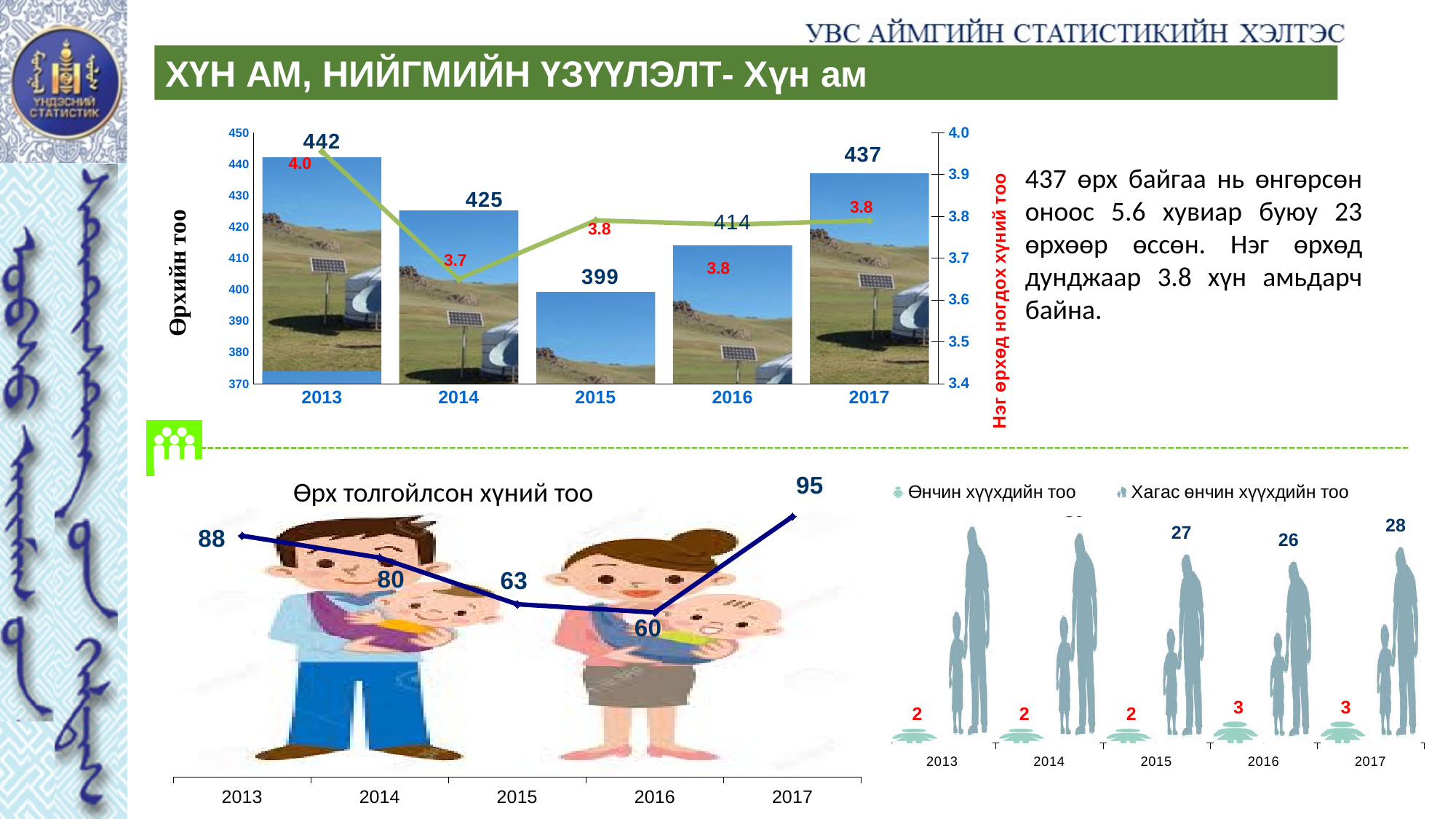
What kind of chart is the bottom-left chart (Өрх толгойлсон хүний тоо)? Line chart In the bottom-right chart, what is the value of Хагас өнчин хүүхдийн тоо in 2017? 28 In the top chart (Өрхийн тоо), what is the number of households in 2015? 399 In the top chart (Өрхийн тоо), which year has the highest number of households? 2013 In the bottom-left chart (Өрх толгойлсон хүний тоо), what is the difference between the 2013 and 2014 values? 8 In the bottom-right chart, how many series does the legend list? 2 In the top chart (Өрхийн тоо), which year has the lowest number of households? 2015 In the top chart, what is the average number of persons per household (red line label) in 2014? 3.7 In the top chart, how many years are shown on the x axis? 5 In the top chart (Өрхийн тоо), what is the difference between the household counts in 2017 and 2016? 23 In the bottom-left chart (Өрх толгойлсон хүний тоо), which year has the highest value? 2017 In the bottom-left chart (Өрх толгойлсон хүний тоо), what is the value for 2016? 60